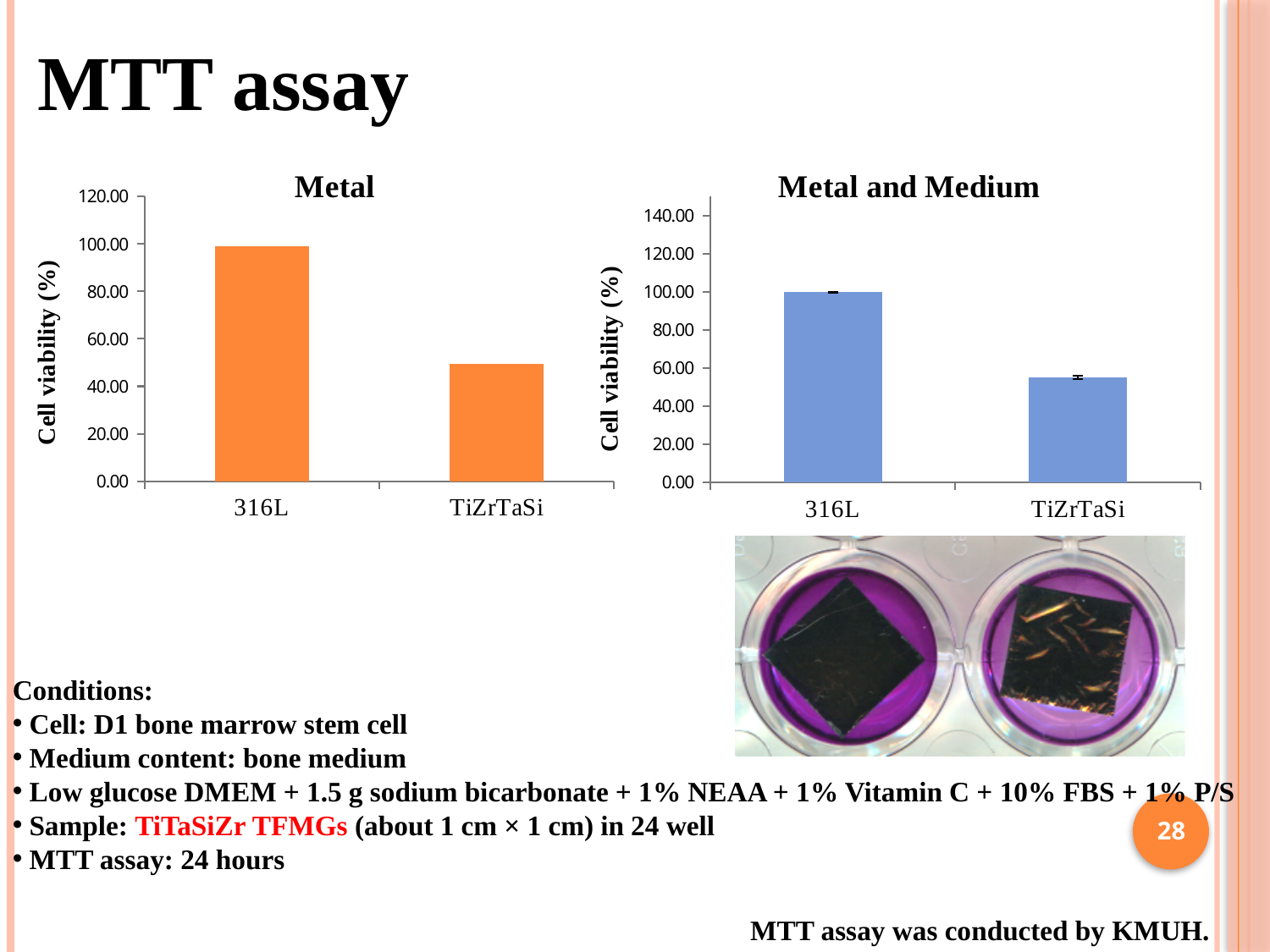
What type of chart is the 'Metal and Medium' chart? Bar chart In the 'Metal and Medium' chart, is the value for 316L greater or less than 80.00? greater In the 'Metal' chart, which category has the higher cell viability? 316L How many categories are shown on the x axis of the 'Metal' chart? 2 In the 'Metal and Medium' chart, which category has the higher cell viability? 316L What is the y-axis label of the 'Metal' chart? Cell viability (%) What is the title of the chart on the right side of the slide? Metal and Medium In the 'Metal' chart, is the value for 316L greater or less than 80.00? greater In the 'Metal and Medium' chart, is the value for TiZrTaSi greater or less than 40.00? greater In the 'Metal' chart, which category has the lower cell viability? TiZrTaSi